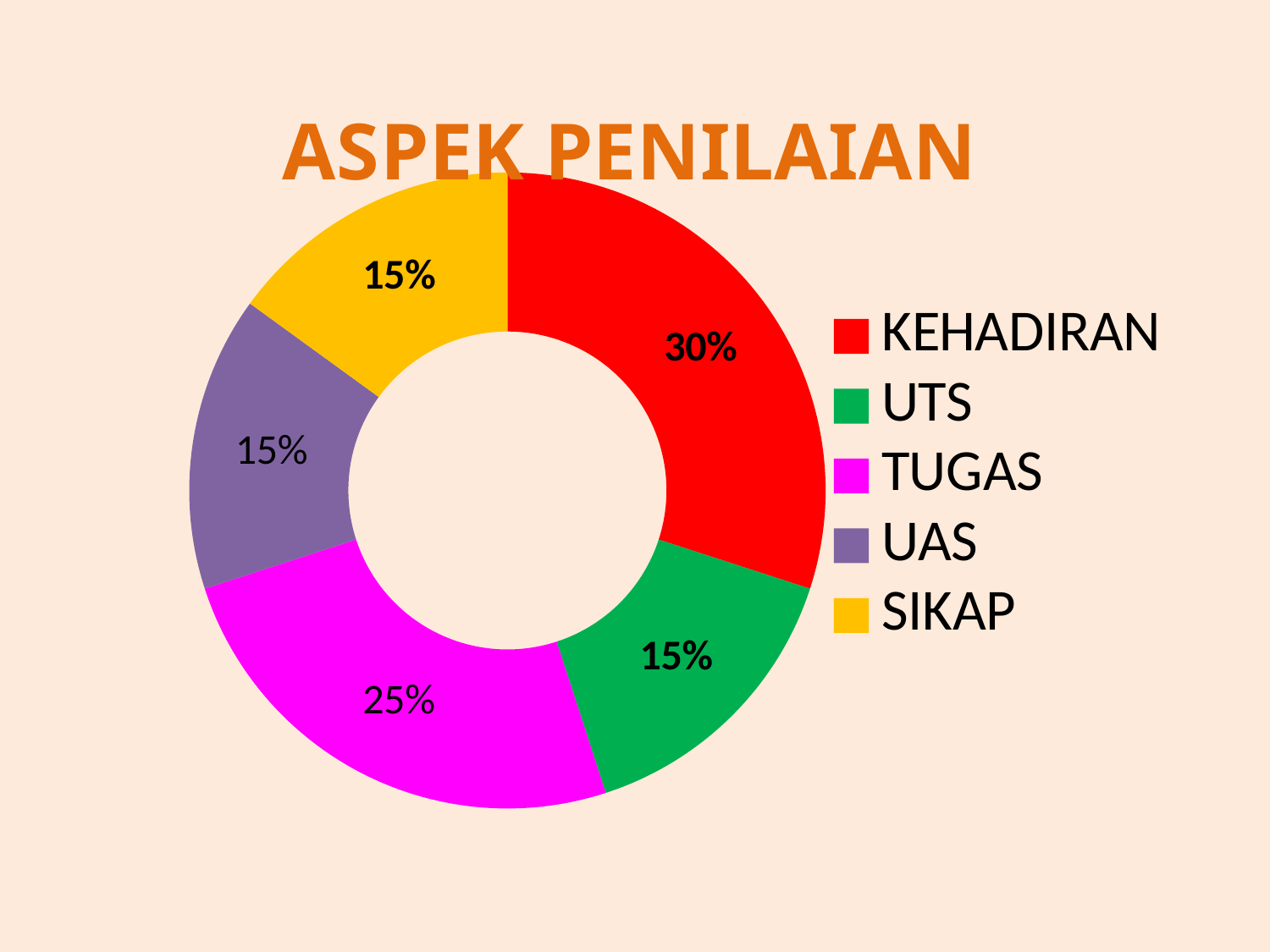
What kind of chart is shown on the slide? Doughnut chart What is the combined share of UTS and UAS? 30% Which category has the largest share of the chart? KEHADIRAN What is the title of the chart? ASPEK PENILAIAN What percentage is shown for SIKAP? 15% What colour represents UAS in the chart? Purple What percentage is shown for UTS? 15% Which is larger, the share for TUGAS or the share for UAS? TUGAS What percentage is shown for TUGAS? 25% What is the difference between the KEHADIRAN and TUGAS percentages? 5% What percentage is shown for KEHADIRAN? 30% How many categories does the legend list? 5